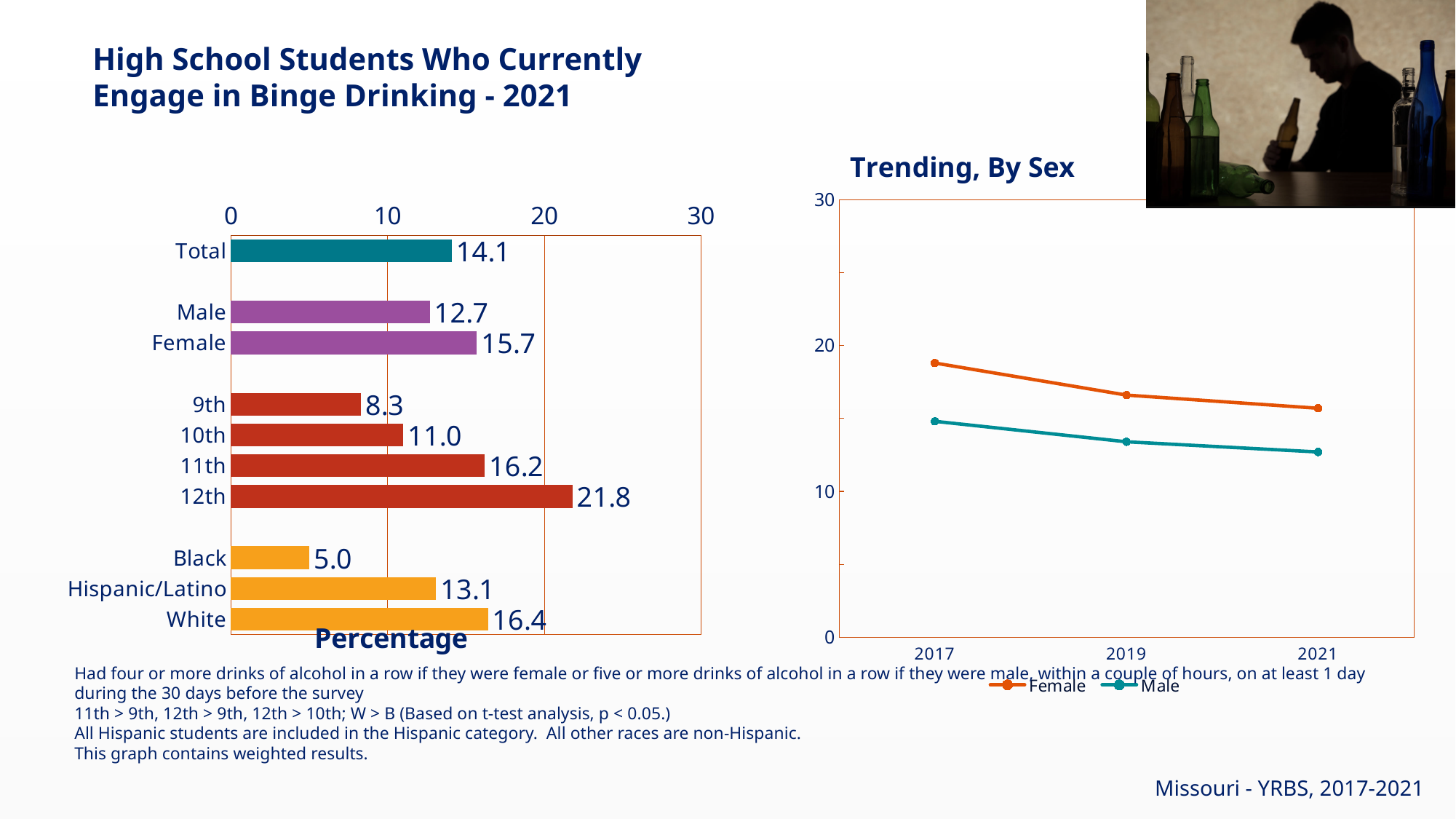
What kind of chart is the 'Trending, By Sex' chart? Line chart In the 'Trending, By Sex' chart, do the Female values rise or fall from 2017 to 2021? Fall In the bar chart on the left, which is larger, the value for 11th grade or the value for White students? White In the 'Trending, By Sex' chart, which series is higher in 2019, Female or Male? Female In the bar chart on the left, what is the value for 12th grade? 21.8 In the bar chart on the left, which category has the highest value? 12th In the 'Trending, By Sex' chart, how many series does the legend list? 2 In the bar chart on the left, what is the value for Hispanic/Latino students? 13.1 In the 'Trending, By Sex' chart, is the Male value for 2017 greater or less than 20? less In the bar chart on the left, which category has the lowest value? Black In the bar chart on the left, how many categories are shown? 10 In the bar chart on the left, what is the difference between the Female and Male values? 3.0